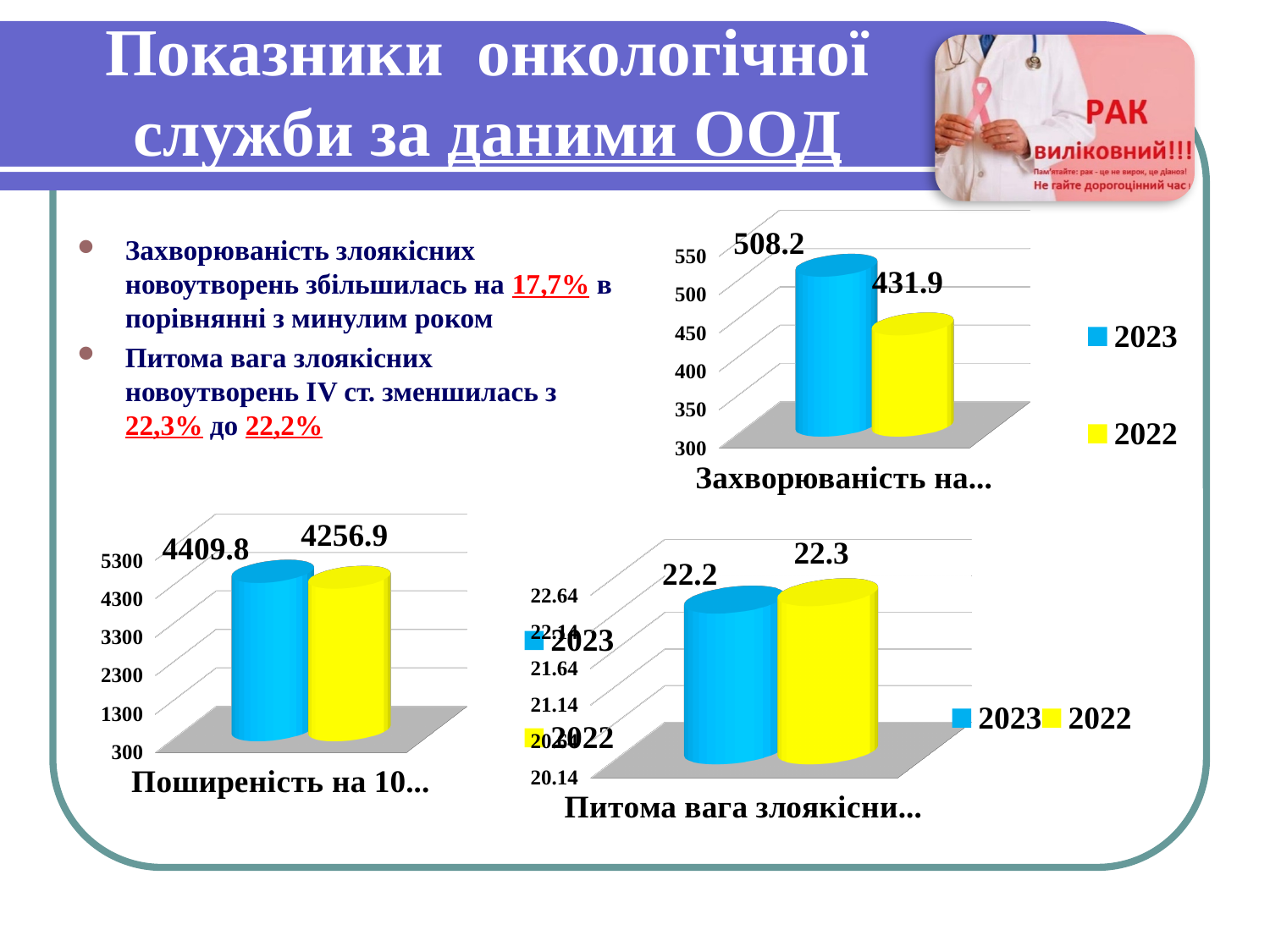
In the top-right chart (Захворюваність на...), what is the value for 2022? 431.9 In the bottom-left chart (Поширеність на 10...), what is the value for 2022? 4256.9 In the bottom-right chart (Питома вага злоякісни...), what is the difference between the 2022 and 2023 values? 0.1 In the bottom-left chart (Поширеність на 10...), what is the value for 2023? 4409.8 In the top-right chart (Захворюваність на...), what is the difference between the 2023 and 2022 values? 76.3 What kind of chart is the top-right chart (Захворюваність на...)? Bar chart In the bottom-left chart (Поширеність на 10...), what is the difference between the 2023 and 2022 values? 152.9 How many series does the legend of the top-right chart (Захворюваність на...) list? 2 In the top-right chart (Захворюваність на...), which year has the higher value? 2023 In the bottom-right chart (Питома вага злоякісни...), what is the value for 2023? 22.2 In the bottom-right chart (Питома вага злоякісни...), what is the value for 2022? 22.3 In the top-right chart (Захворюваність на...), what is the value for 2023? 508.2